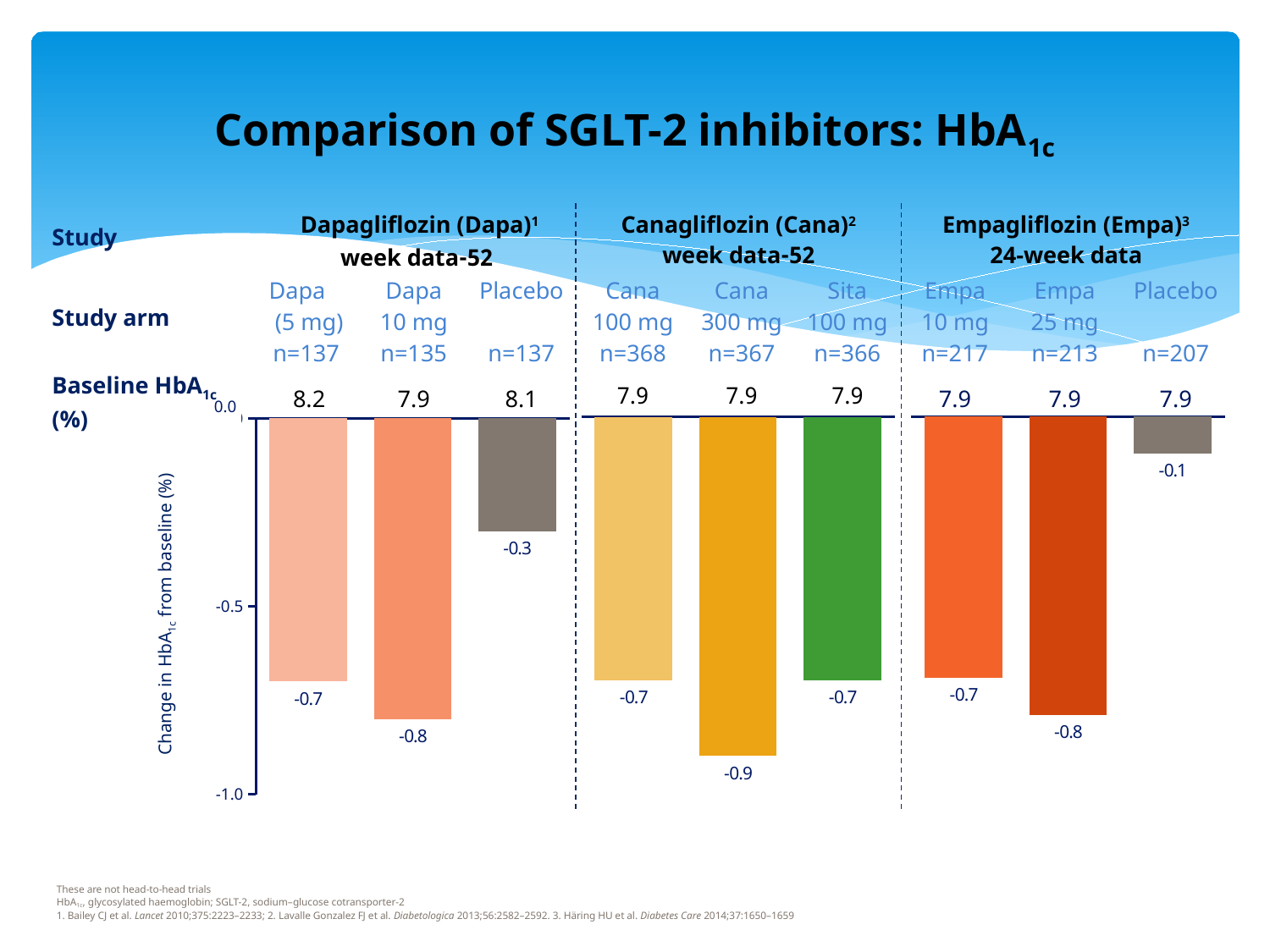
Is the change in HbA1c for the Placebo arm in the Dapagliflozin study greater or less than -0.5? greater What type of chart is shown on the slide? Bar chart What is the difference between the change in HbA1c for Cana 300 mg and Cana 100 mg? 0.2 What is the baseline HbA1c (%) for the Dapa 5 mg arm? 8.2 Which arm has a larger reduction in HbA1c: Empa 25 mg or Empa 10 mg? Empa 25 mg How many study arms (bars) are plotted in the chart? 9 What is the label of the vertical axis of the chart? Change in HbA1c from baseline (%) Which study arm shows the smallest change in HbA1c from baseline? Placebo (Empagliflozin study) Which study arm shows the largest reduction in HbA1c from baseline? Cana 300 mg What is the change in HbA1c from baseline for the Dapa 10 mg arm? -0.8 What is the change in HbA1c from baseline for the Placebo arm in the Empagliflozin study? -0.1 What is the change in HbA1c from baseline for the Cana 300 mg arm? -0.9